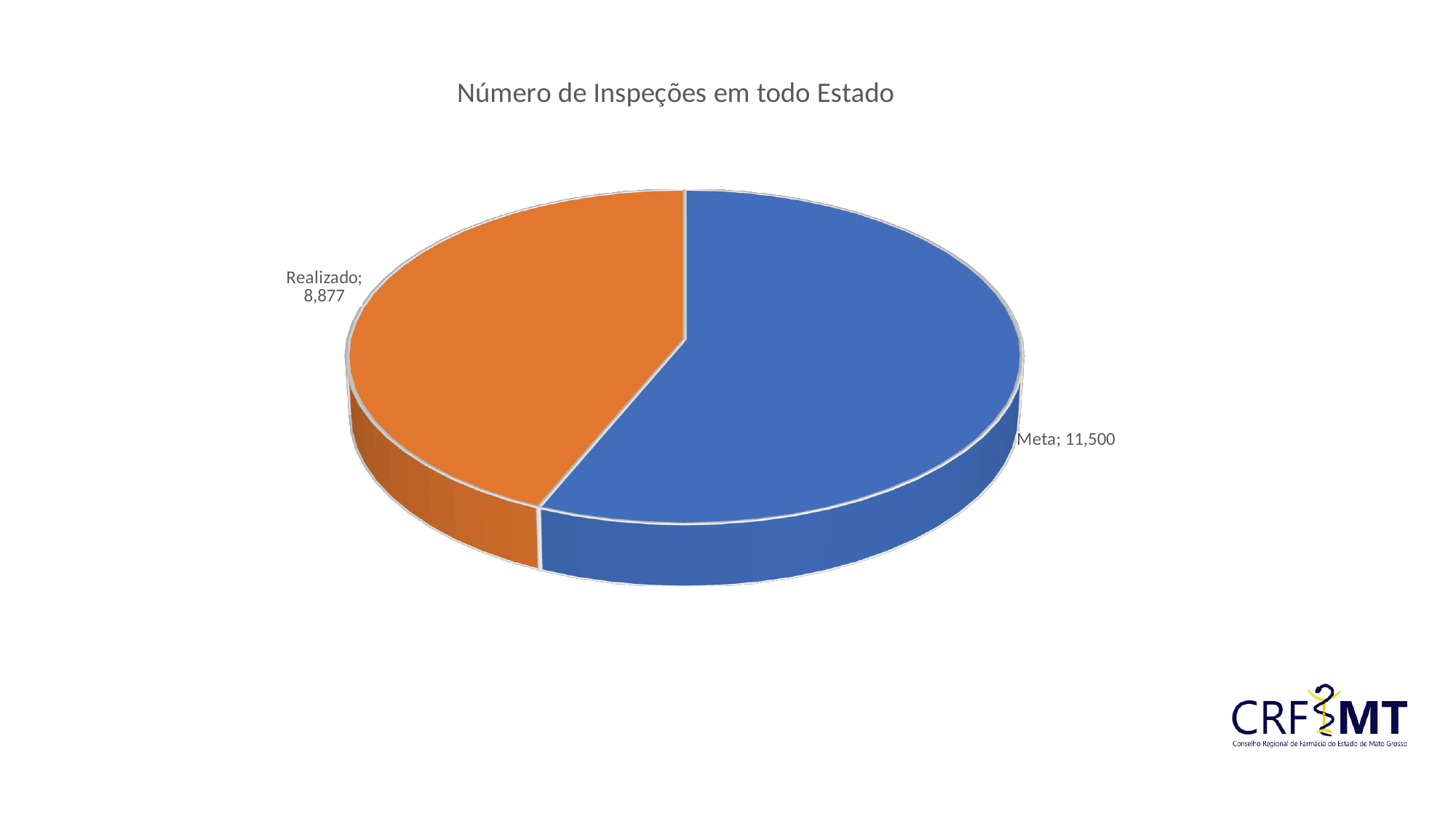
How many slices does the pie chart have? 2 What is the title of the pie chart? Número de Inspeções em todo Estado What is the difference between the Meta value and the Realizado value? 2,623 Which slice of the pie chart is the smallest? Realizado What kind of chart is shown on the slide? Pie chart What colour is the Realizado slice in the pie chart? Orange Which slice of the pie chart is the largest? Meta What is the value of the Meta slice in the pie chart? 11,500 What is the total of the two values shown in the pie chart? 20,377 What is the value of the Realizado slice in the pie chart? 8,877 Which is larger, the Meta value or the Realizado value? Meta What share of the pie does the Meta slice represent, to one decimal place? 56.4%